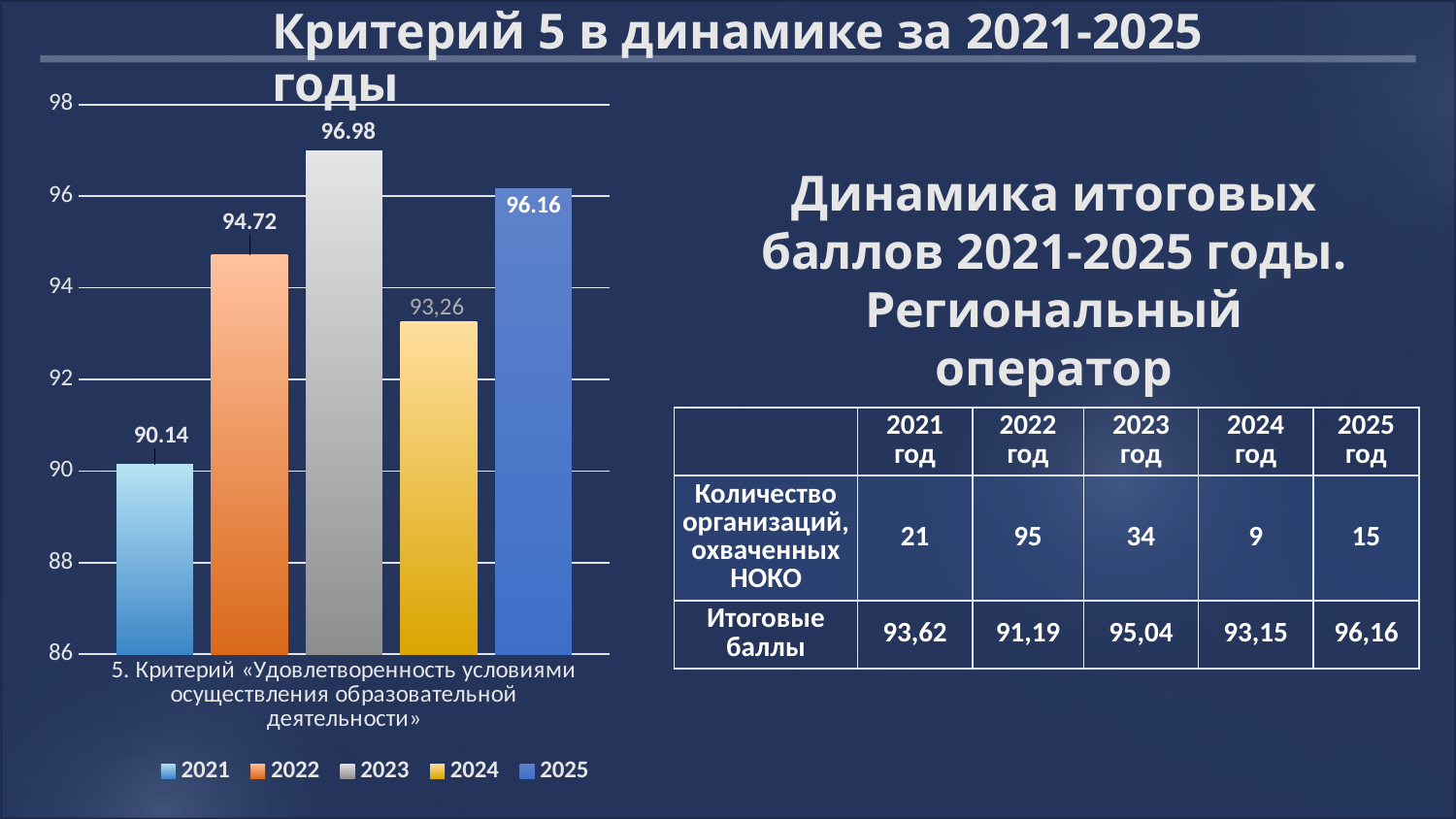
What type of chart is shown on the left of the slide? bar chart What is the value for 2023 in the bar chart? 96.98 How many series does the legend of the bar chart list? 5 What is the difference between the 2023 and 2022 values in the bar chart? 2.26 What is the difference between the 2025 and 2021 values in the bar chart? 6.02 What is the value for 2021 in the bar chart? 90.14 Which year has the lowest value in the bar chart? 2021 Which year has the highest value in the bar chart? 2023 Is the value for 2024 in the bar chart greater or less than 94? less Which is larger in the bar chart, the value for 2022 or the value for 2024? 2022 What is the value for 2024 in the bar chart? 93,26 What is the value for 2025 in the bar chart? 96.16